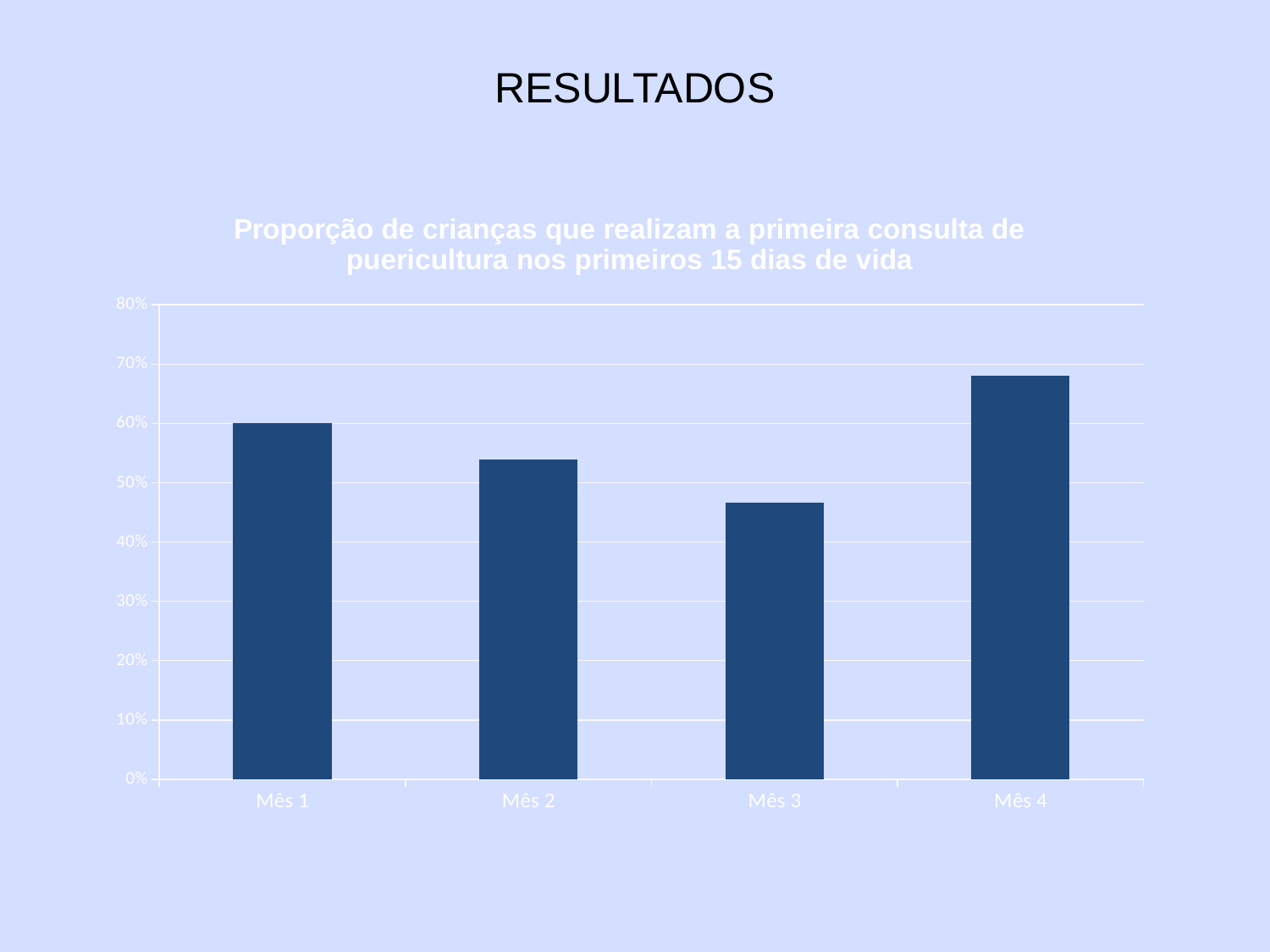
How many categories (months) are shown on the x axis of the chart? 4 Is the value for Mês 2 greater or less than 50%? greater Which month has the lowest proportion in the chart? Mês 3 Do the values rise or fall from Mês 1 to Mês 3? fall Is the value for Mês 4 greater or less than 70%? less What kind of chart is shown on the slide? bar chart Which month has the highest proportion in the chart? Mês 4 Which is larger, the value for Mês 1 or the value for Mês 2? Mês 1 Is the value for Mês 4 greater or less than 60%? greater What is the title of the chart? Proporção de crianças que realizam a primeira consulta de puericultura nos primeiros 15 dias de vida What is the value for Mês 1? 60%